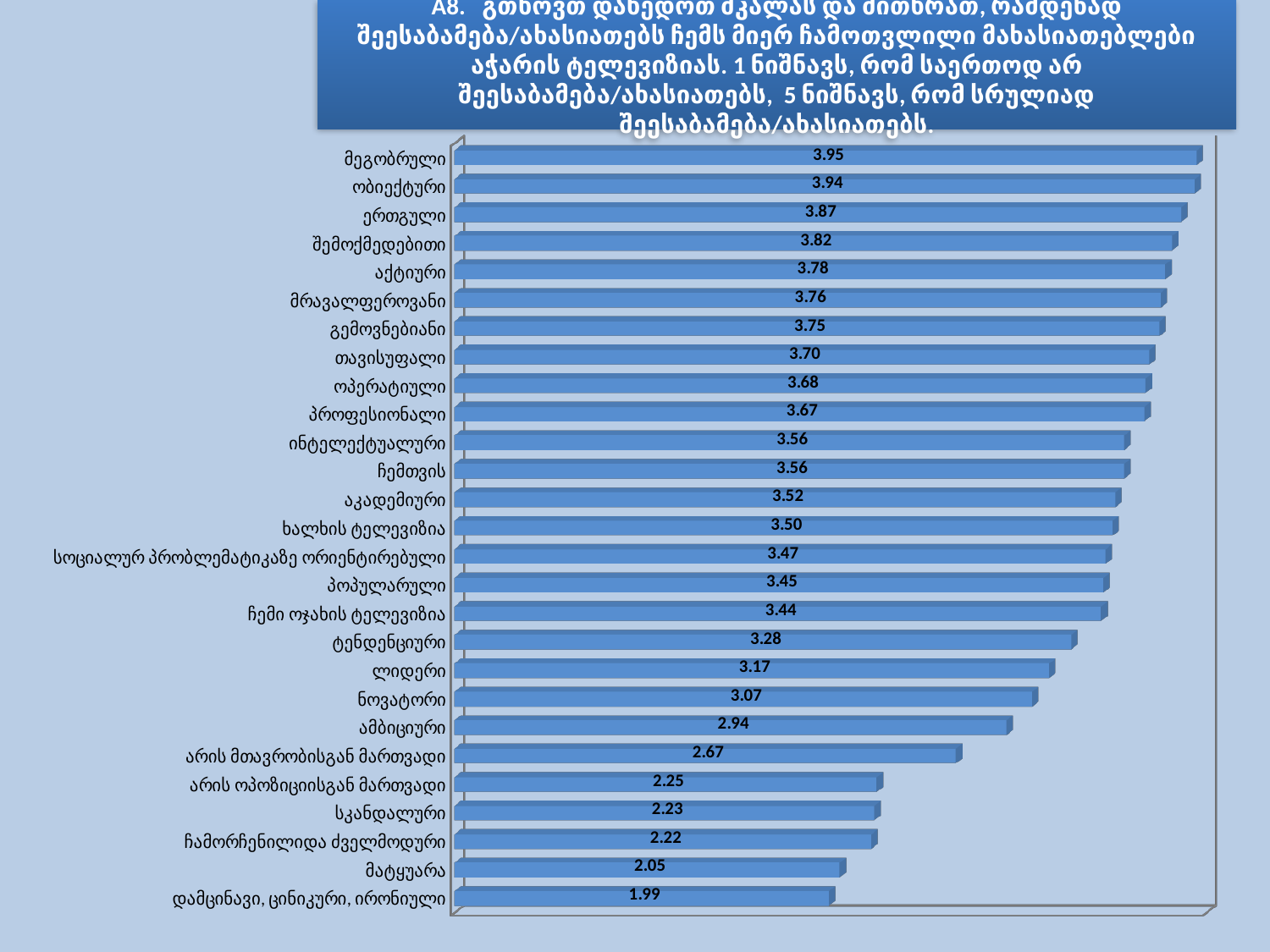
Which category has the lowest value? დამცინავი, ცინიკური, ირონიული Which category has the highest value? მეგობრული Which is larger, the value for ამბიციური or the value for არის ოპოზიციისგან მართვადი? ამბიციური What is the value for არის მთავრობისგან მართვადი? 2.67 What is the value for მატყუარა? 2.05 What kind of chart is shown on the slide? bar chart What is the difference between the values for ლიდერი and სკანდალური? 0.94 How many categories are shown in the chart? 27 What is the value for ხალხის ტელევიზია? 3.50 What is the value for ტენდენციური? 3.28 What is the difference between the values for ობიექტური and ნოვატორი? 0.87 What is the value for მეგობრული? 3.95